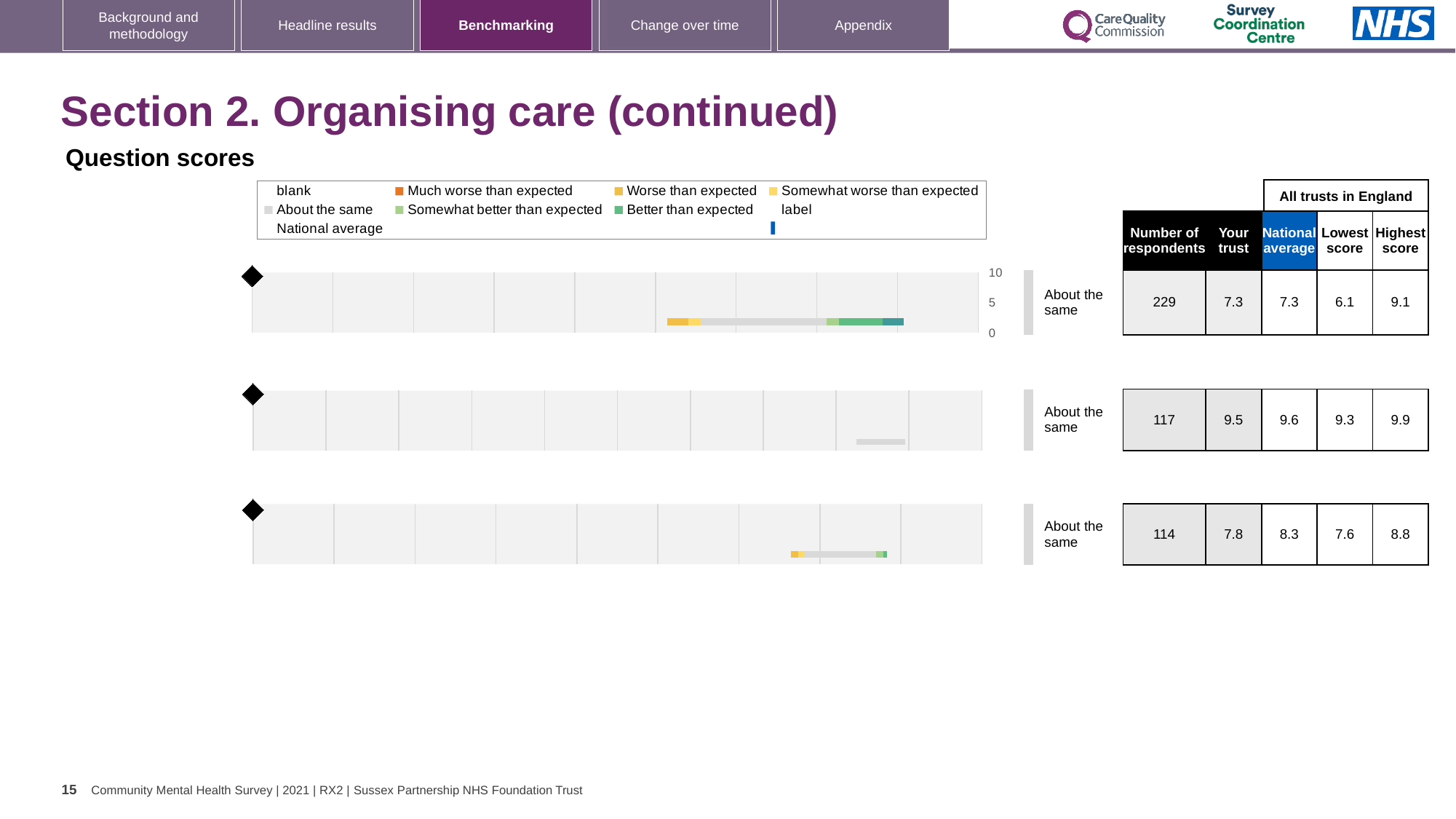
For the second row (117 respondents), what is the difference between the highest score and the lowest score? 0.6 What kind of chart is used for the benchmarking charts on the slide? bar chart For the third row (114 respondents), what is the difference between the highest score and the lowest score? 1.2 Which row of the table has the largest number of respondents? the first row (229) In the table, what is the lowest score for the third row (114 respondents)? 7.6 What benchmark category label is shown next to each of the three charts? About the same In the table, what is the 'Your trust' score for the first row (229 respondents)? 7.3 In the table, what is the national average for the second row (117 respondents)? 9.6 For the third row (114 respondents), which is larger: the 'Your trust' score or the national average? National average What is the maximum value shown on the vertical axis of the top chart? 10 How many benchmarking charts are shown on the slide? 3 In the table, what is the highest score for the first row (229 respondents)? 9.1